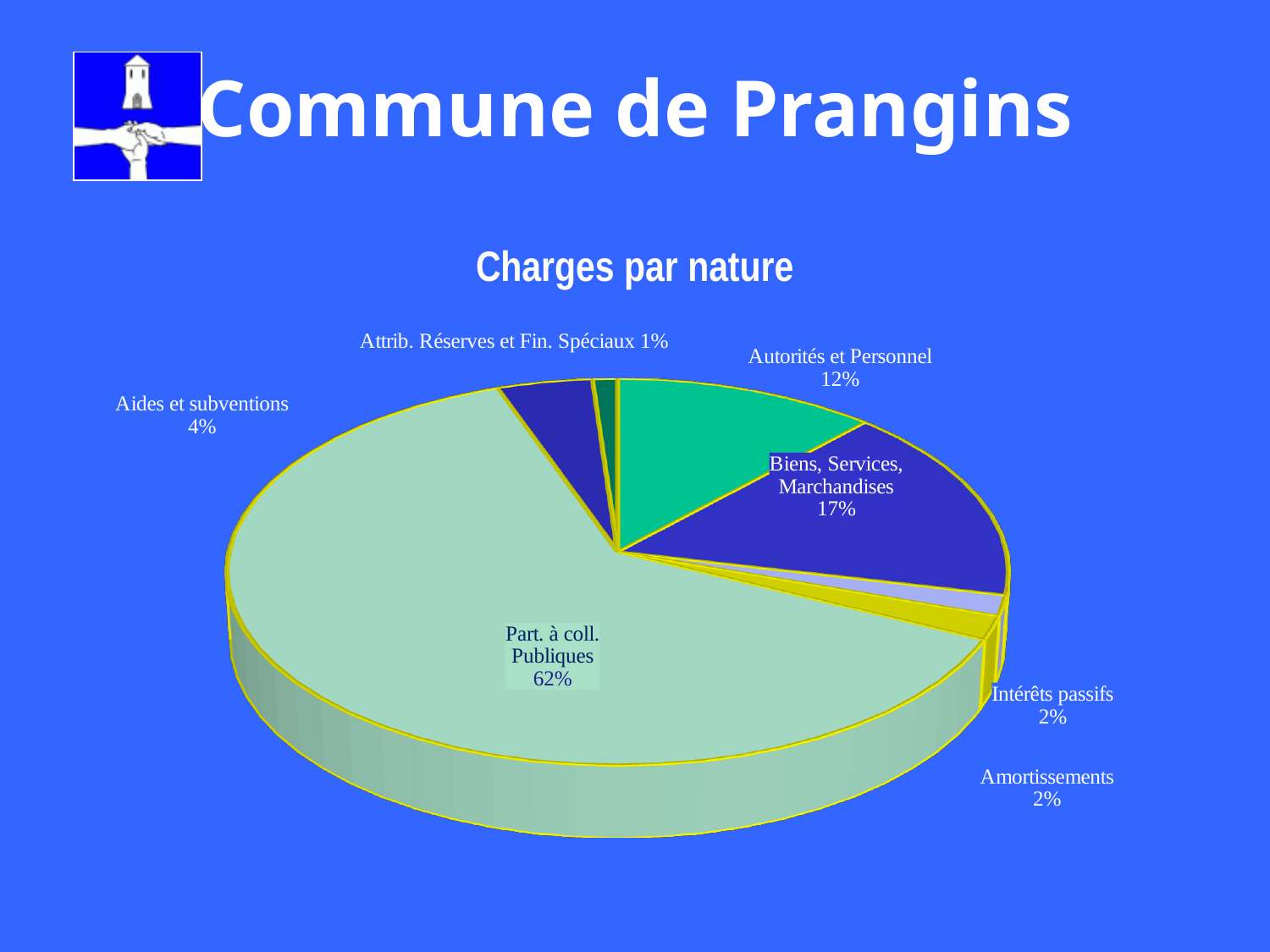
Which is larger, Aides et subventions or Intérêts passifs? Aides et subventions Which category has the smallest slice of the pie? Attrib. Réserves et Fin. Spéciaux How many categories are shown in the pie chart? 7 Which category has the largest slice of the pie? Part. à coll. Publiques What percentage is labelled for Attrib. Réserves et Fin. Spéciaux? 1% What share is shown for Aides et subventions? 4% What percentage does Biens, Services, Marchandises represent? 17% What is the share of Part. à coll. Publiques in the Charges par nature pie chart? 62% What type of chart is shown on the slide? Pie chart What is the value shown for Autorités et Personnel? 12% What is the title of the chart? Charges par nature What is the difference in percentage points between Biens, Services, Marchandises and Autorités et Personnel? 5